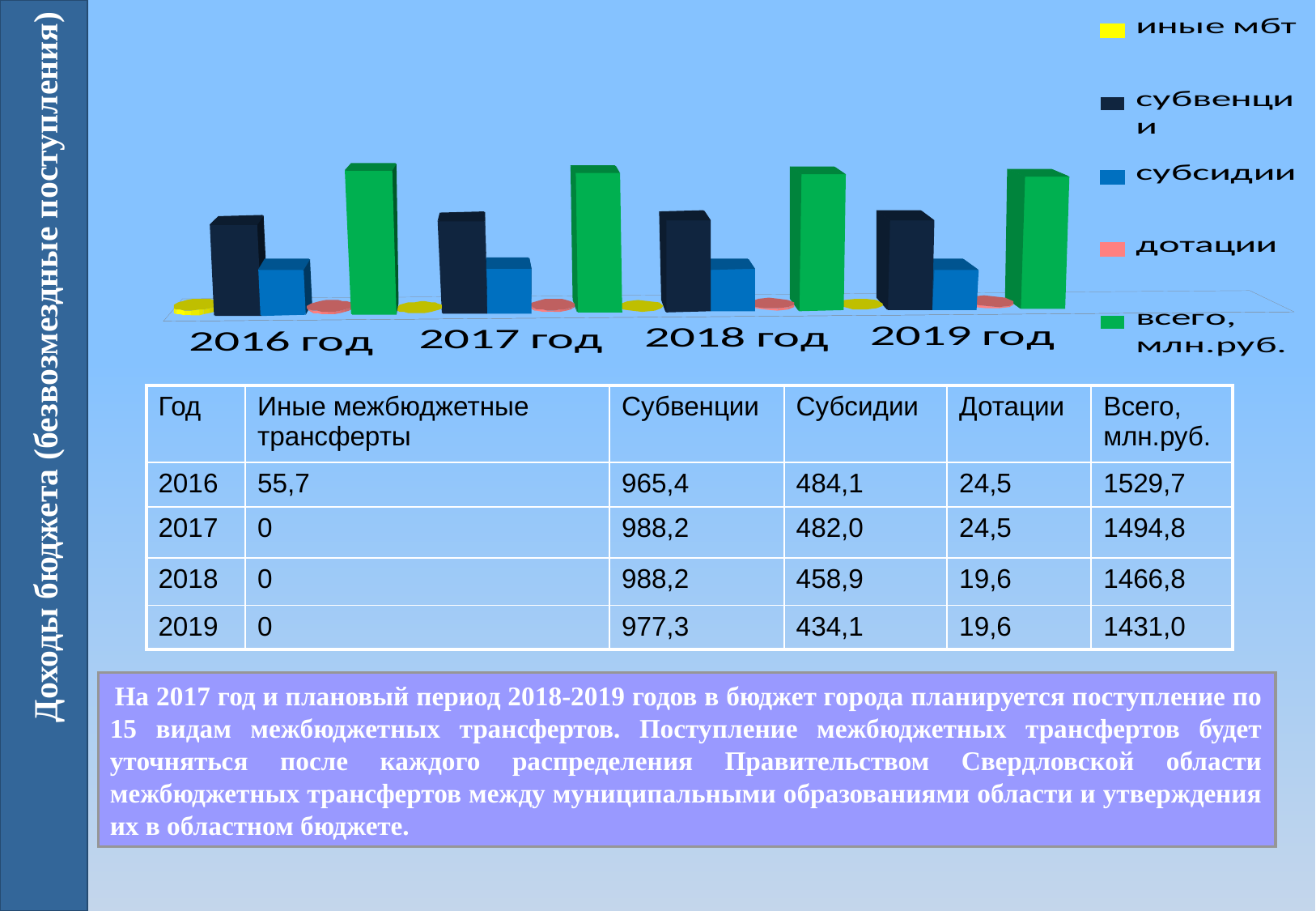
In the 2016 group, which bar is taller: субвенции or субсидии? субвенции Which year has the lowest 'Всего, млн.руб.' value? 2019 Which series has the tallest bar in every year group of the chart? всего, млн.руб. How many series does the chart legend list? 5 How many year categories are shown on the x axis of the chart? 4 What kind of chart is shown on the slide? bar chart What is the value of 'Всего, млн.руб.' for 2016? 1529,7 Which series is shown in green in the chart? всего, млн.руб. What is the value of 'Субвенции' for 2019? 977,3 Which series is shown in yellow in the chart? иные мбт Does the green 'всего' bar rise or fall from 2016 to 2019? fall What is the difference between the 'Субсидии' values for 2016 and 2019? 50,0